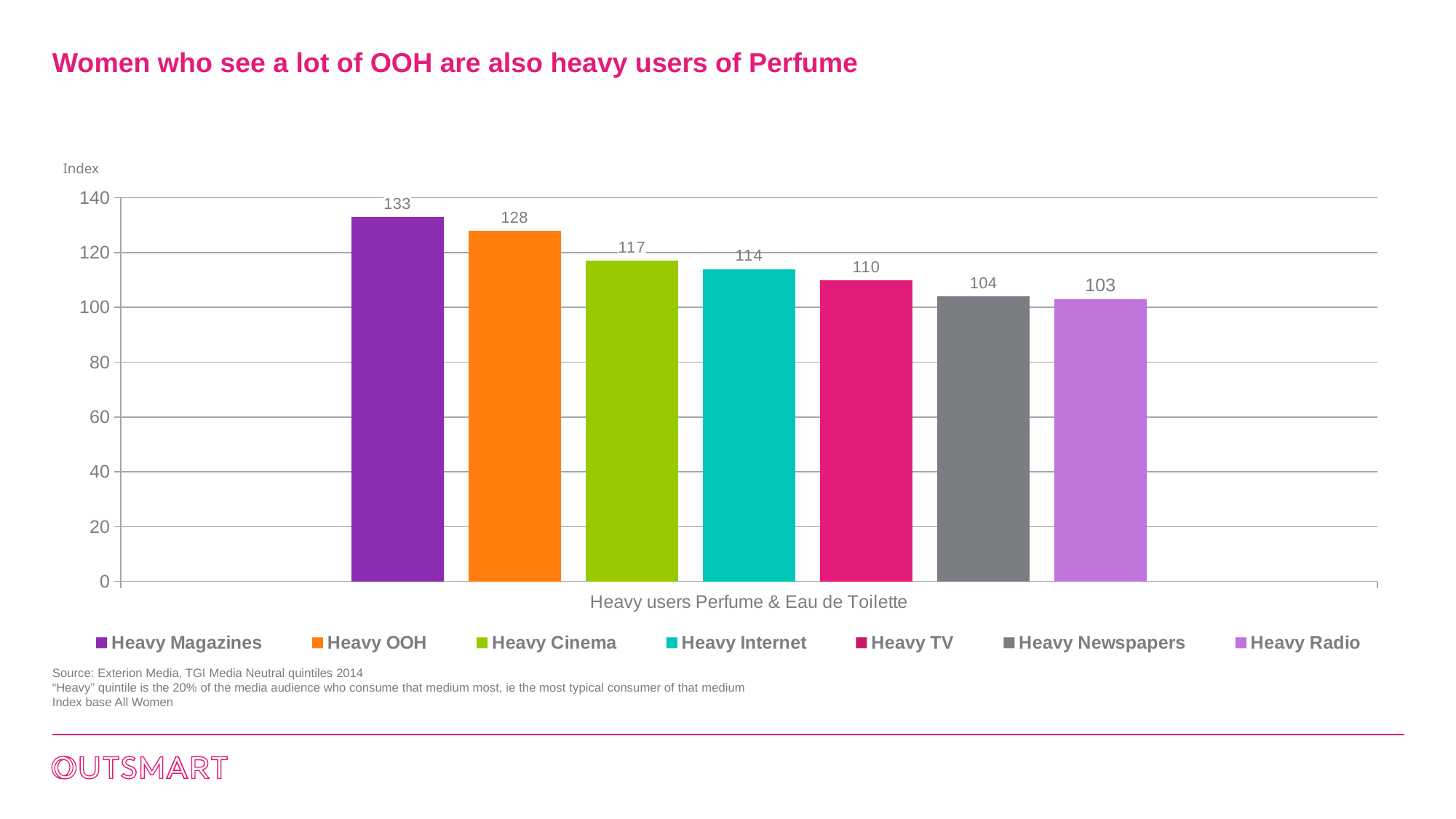
What is the index value for Heavy Cinema? 117 What is the difference between the index values for Heavy Magazines and Heavy OOH? 5 What is the label on the x axis of the chart? Heavy users Perfume & Eau de Toilette What is the index value for Heavy OOH? 128 Which series has the highest index value? Heavy Magazines How many series does the legend list? 7 What is the difference between the index values for Heavy Internet and Heavy Newspapers? 10 Which series has the lowest index value? Heavy Radio Is the value for Heavy Newspapers greater or less than 100? greater What is the index value for Heavy Radio? 103 Which has a higher index value, Heavy TV or Heavy Cinema? Heavy Cinema What kind of chart is shown on the slide? Bar chart